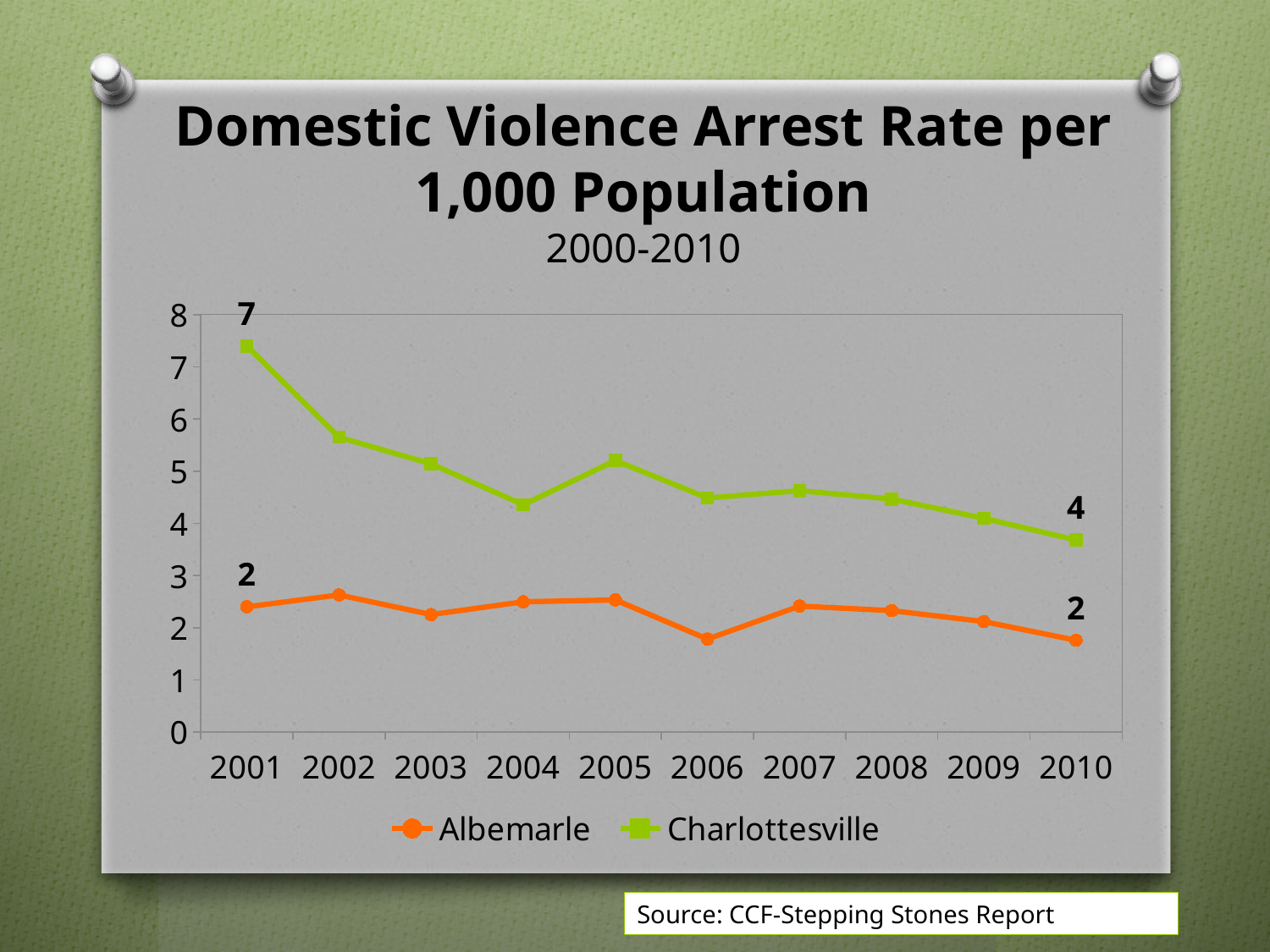
In 2005, which had the higher arrest rate, Albemarle or Charlottesville? Charlottesville What kind of chart is shown on the slide? line chart What is the Albemarle domestic violence arrest rate in 2010? 2 By how much did the Charlottesville arrest rate fall from 2001 to 2010, using the printed labels? 3 How many series does the legend list? 2 How many years are plotted along the x axis? 10 In which year is the Charlottesville arrest rate highest? 2001 What is the Charlottesville domestic violence arrest rate in 2001? 7 What is the Charlottesville domestic violence arrest rate in 2010? 4 What is the Albemarle domestic violence arrest rate in 2001? 2 Is the Charlottesville value for 2002 greater or less than 5? greater Does the Charlottesville line generally rise or fall from 2001 to 2010? fall